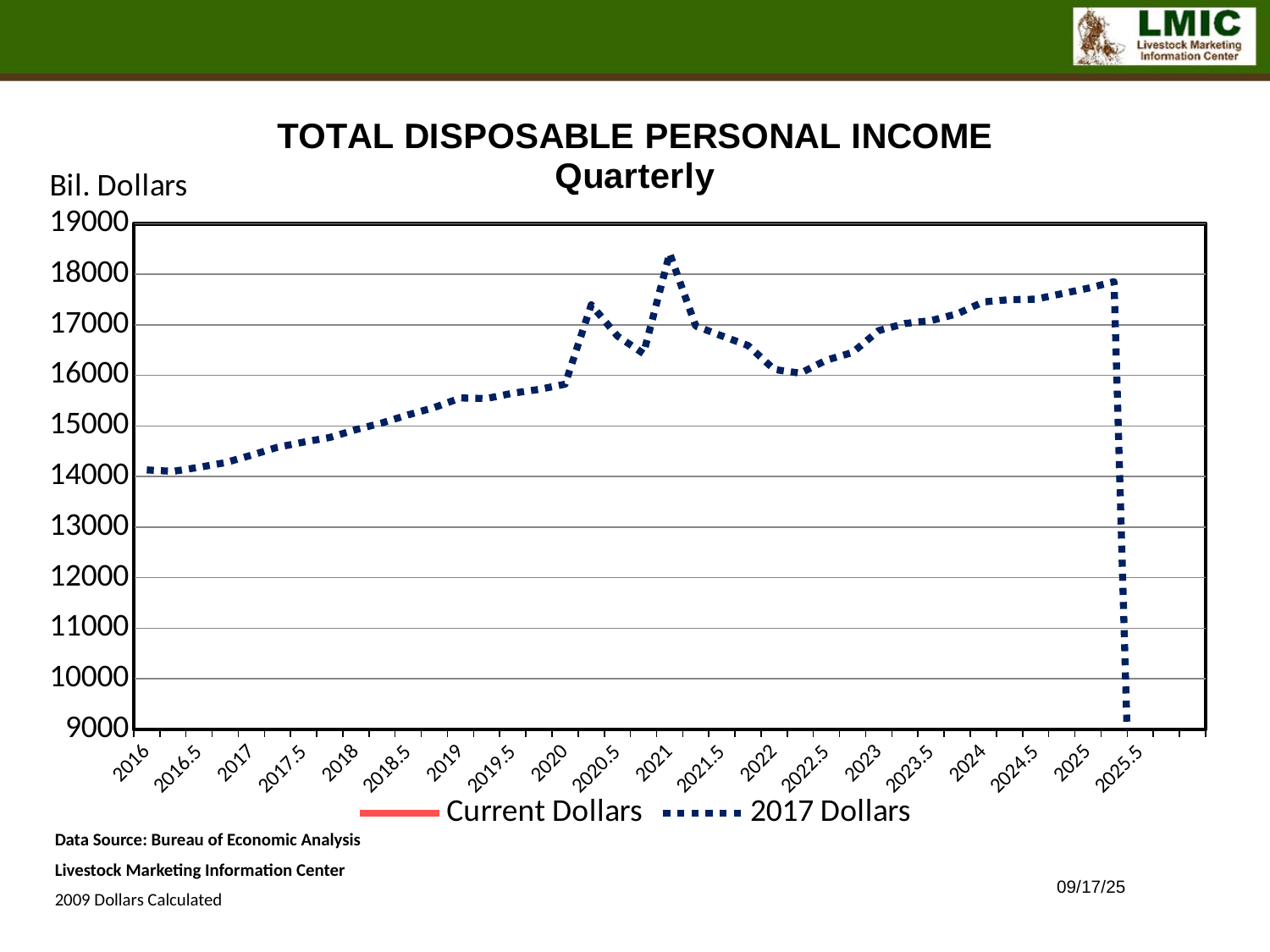
Is the 2017 Dollars value at 2025 greater or less than 17000? greater What kind of chart is shown on the slide? line chart Which is lower for the 2017 Dollars series, the value at 2016 or the value at 2025? 2016 Is the 2017 Dollars value at 2019 greater or less than 15000? greater Is the 2017 Dollars value at 2021 greater or less than 18000? greater Which is higher for the 2017 Dollars series, the value at 2021 or the value at 2022? 2021 What unit label is shown above the vertical axis? Bil. Dollars Does the 2017 Dollars line generally rise or fall between 2016 and 2020? rise What is the title of the chart? TOTAL DISPOSABLE PERSONAL INCOME Quarterly How many series does the legend list? 2